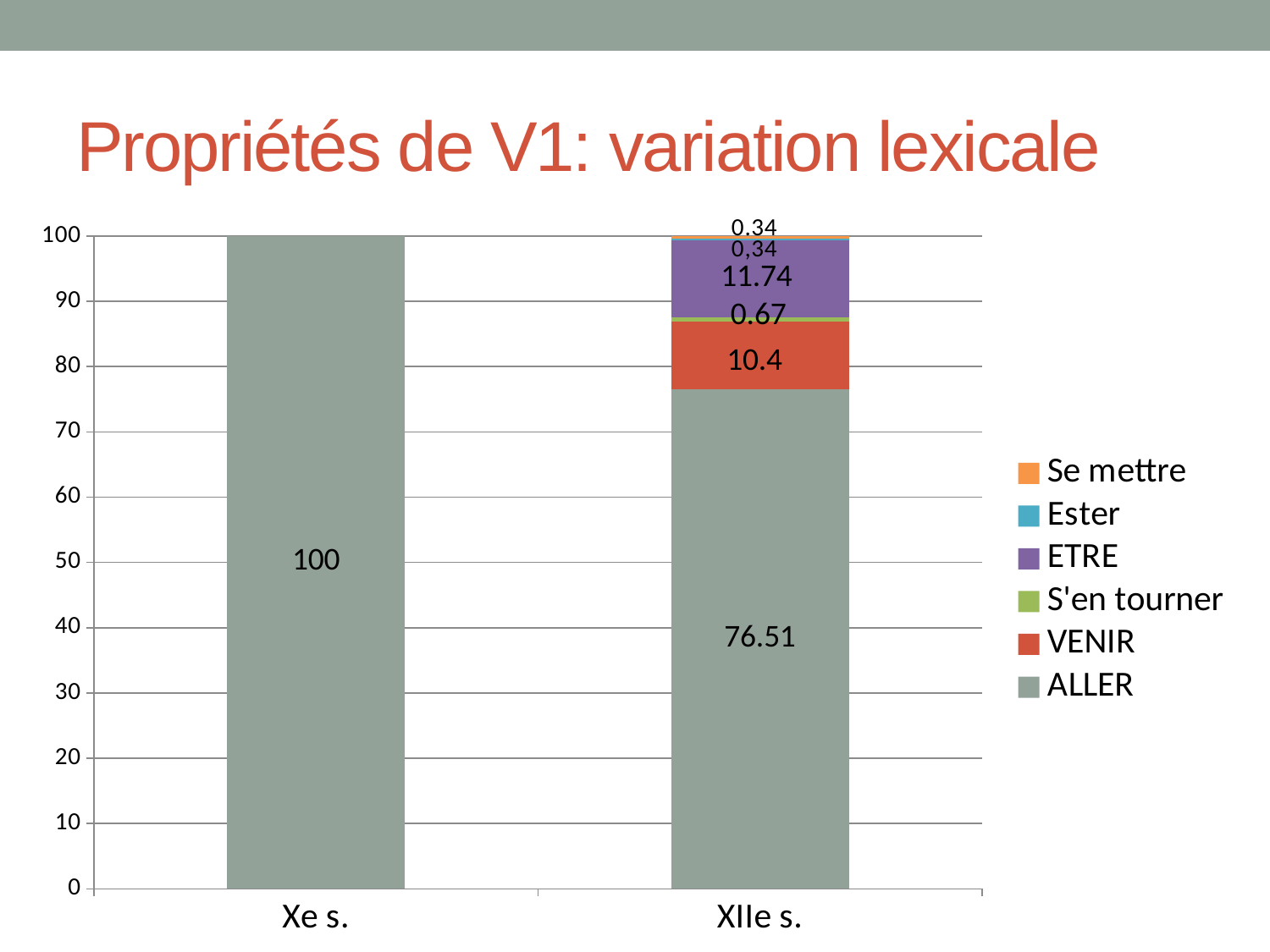
In the XIIe s. bar, which is larger, the ETRE segment or the VENIR segment? ETRE What kind of chart is shown on the slide? stacked bar chart What is the title of the slide containing the chart? Propriétés de V1: variation lexicale How many series does the legend list? 6 How many categories are shown on the x axis? 2 Which series has the largest segment in the XIIe s. bar? ALLER What is the difference between the ALLER value for Xe s. and the ALLER value for XIIe s.? 23.49 What is the value for VENIR in the XIIe s. bar? 10.4 What is the value for ALLER in the XIIe s. bar? 76.51 What is the value for ETRE in the XIIe s. bar? 11.74 What is the value for ALLER in the Xe s. bar? 100 What is the value for S'en tourner in the XIIe s. bar? 0.67